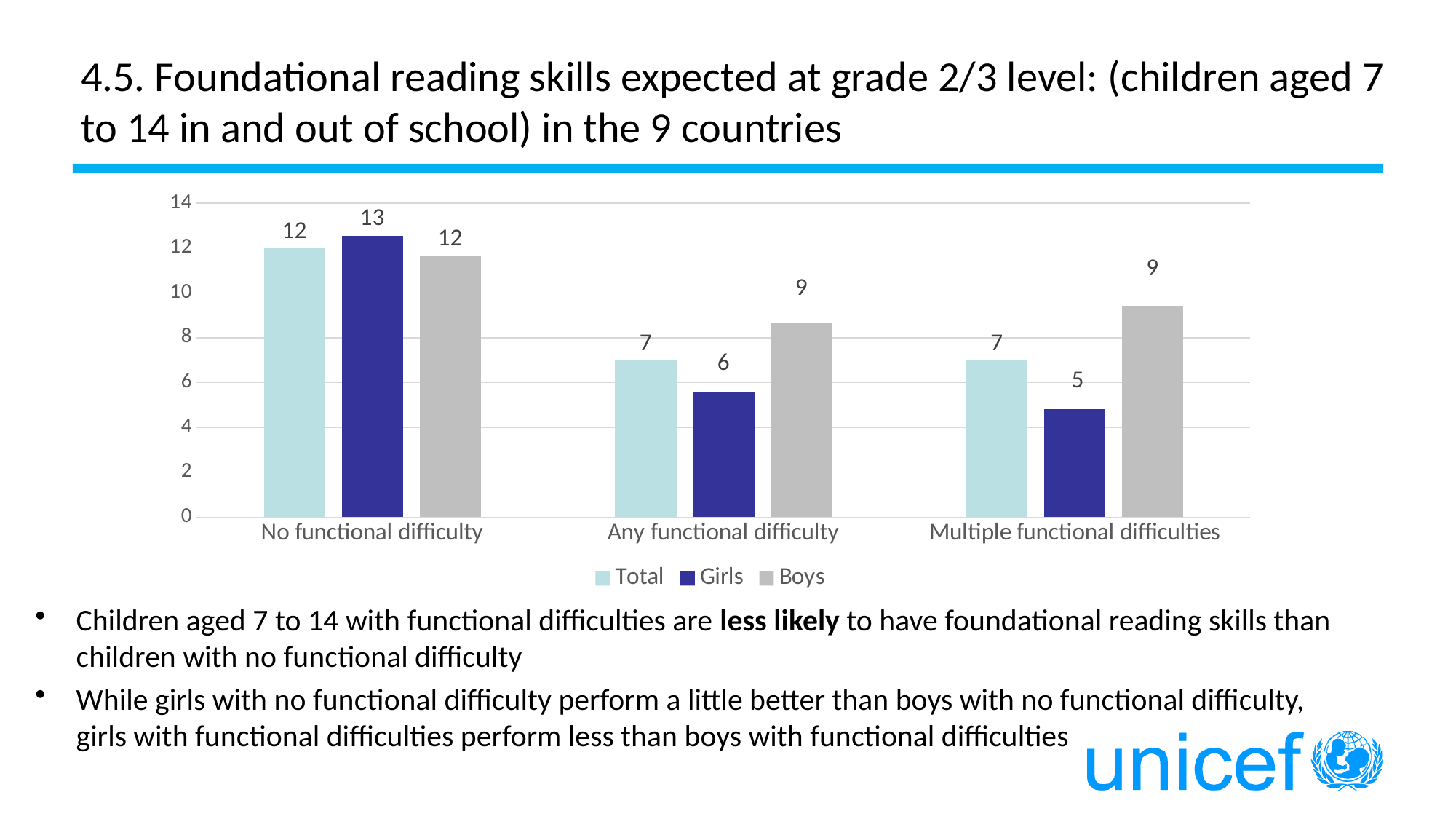
In the Any functional difficulty category, which is larger, the Girls value or the Boys value? Boys Is the value for Boys in the No functional difficulty category greater or less than 10? greater How many categories are shown on the x axis? 3 How many series does the legend list? 3 Which category has the highest value for Girls? No functional difficulty What is the difference between the Girls value and the Boys value in the Multiple functional difficulties category? 4 What is the value for Girls in the No functional difficulty category? 13 What is the value for Boys in the Any functional difficulty category? 9 What kind of chart is shown on the slide? Bar chart What is the value for Total in the Multiple functional difficulties category? 7 What is the value for Girls in the Multiple functional difficulties category? 5